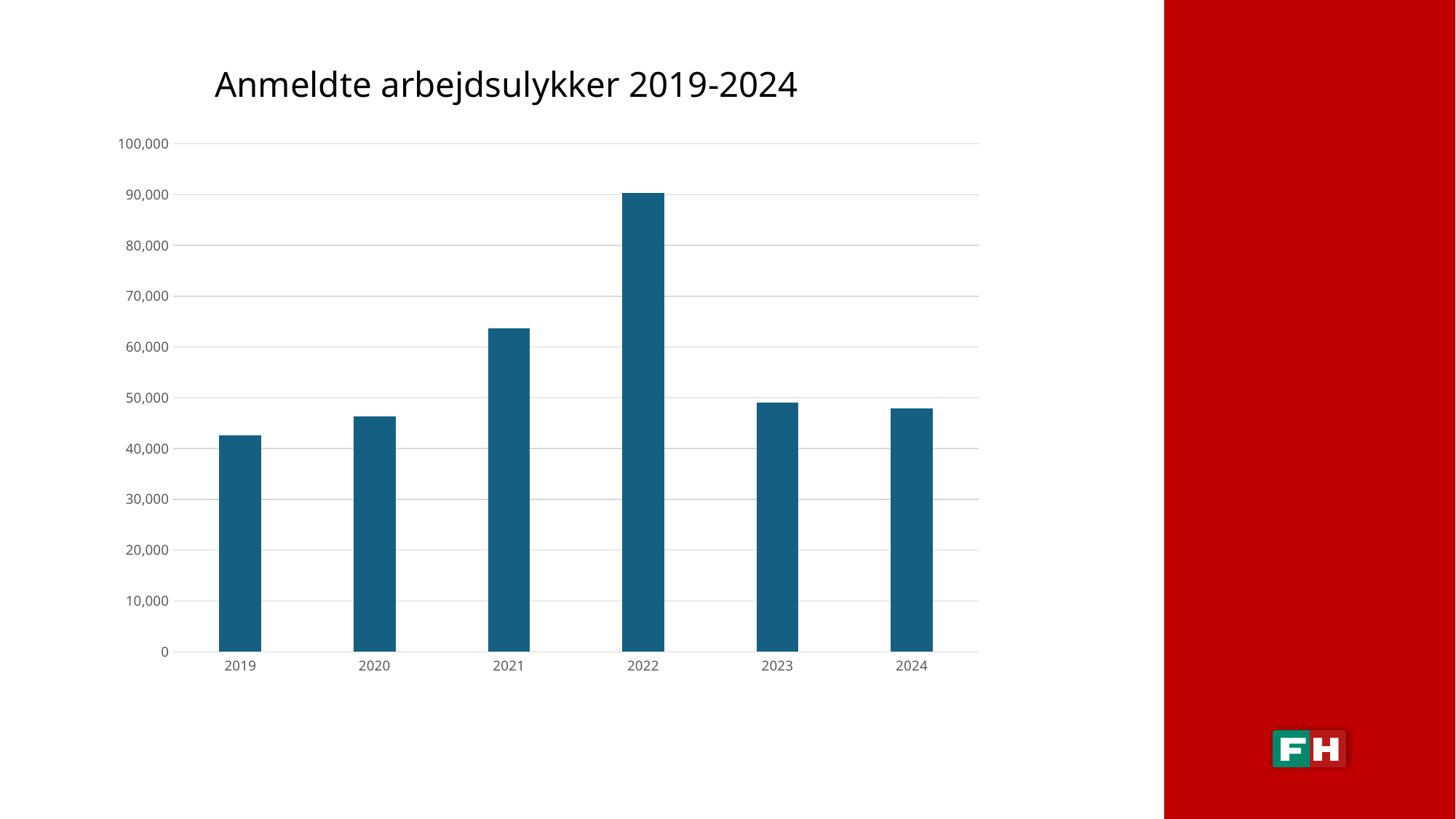
Which year has the larger value, 2021 or 2023? 2021 Which year has the highest number of reported accidents? 2022 Is the value for 2022 greater or less than 80,000? greater Do the values rise or fall from 2019 to 2022? rise Which year has the larger value, 2019 or 2020? 2020 What kind of chart is shown on the slide? bar chart Is the value for 2024 greater or less than 50,000? less Is the value for 2021 greater or less than 60,000? greater Which year has the lowest number of reported accidents? 2019 What is the title of the chart? Anmeldte arbejdsulykker 2019-2024 How many years are shown on the x axis of the chart? 6